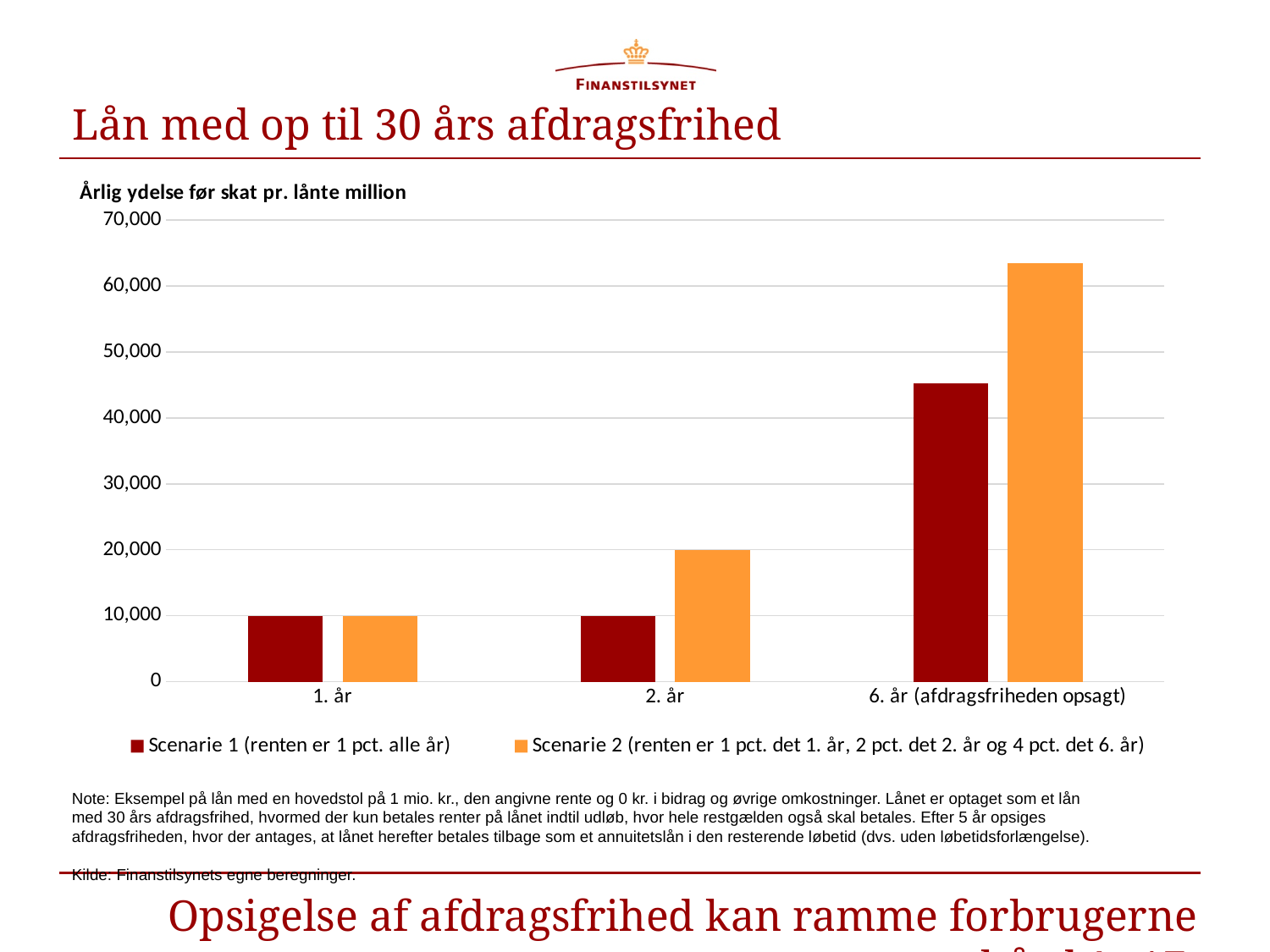
What is the difference between Scenarie 2 and Scenarie 1 in 2. år? 10,000 Do the values for Scenarie 2 rise or fall from 1. år to 6. år? Rise What is the value for Scenarie 1 in 2. år? 10,000 What kind of chart is shown on the slide? Bar chart In which category does Scenarie 2 reach its highest value? 6. år (afdragsfriheden opsagt) Is the value for Scenarie 2 in 6. år (afdragsfriheden opsagt) greater or less than 60,000? greater How many series does the legend list? 2 In 6. år (afdragsfriheden opsagt), which series has the larger value, Scenarie 1 or Scenarie 2? Scenarie 2 What is the value for Scenarie 1 in 1. år? 10,000 What is the value for Scenarie 2 in 2. år? 20,000 Is the value for Scenarie 1 in 6. år (afdragsfriheden opsagt) greater or less than 40,000? greater How many categories are shown on the x axis? 3